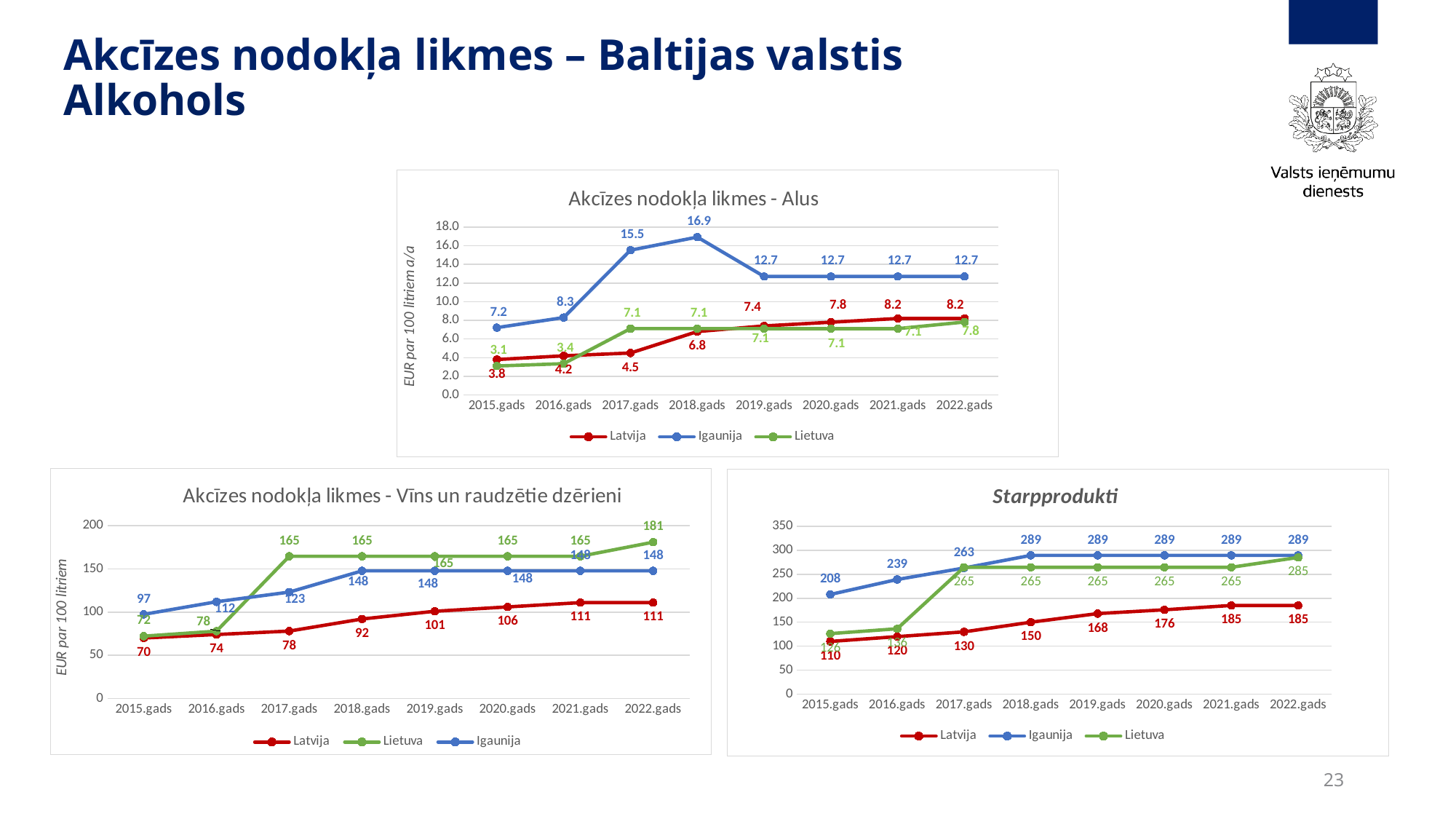
In the 'Akcīzes nodokļa likmes - Alus' chart, what is the value for Latvija in 2022.gads? 8.2 In the 'Akcīzes nodokļa likmes - Vīns un raudzētie dzērieni' chart, which is larger in 2017.gads: Lietuva or Igaunija? Lietuva In the 'Starpprodukti' chart, what is the difference between the Igaunija and Latvija values in 2022.gads? 104 In the 'Akcīzes nodokļa likmes - Alus' chart, what is the difference between the Igaunija and Latvija values in 2017.gads? 11.0 In the 'Akcīzes nodokļa likmes - Alus' chart, which year has the highest value for Igaunija? 2018.gads In the 'Akcīzes nodokļa likmes - Alus' chart, how many series does the legend list? 3 What type of chart is the 'Starpprodukti' chart? Line chart In the 'Akcīzes nodokļa likmes - Vīns un raudzētie dzērieni' chart, what is the value for Lietuva in 2022.gads? 181 In the 'Starpprodukti' chart, what is the value for Igaunija in 2016.gads? 239 In the 'Akcīzes nodokļa likmes - Vīns un raudzētie dzērieni' chart, which year has the lowest value for Latvija? 2015.gads In the 'Akcīzes nodokļa likmes - Alus' chart, what is the value for Igaunija in 2018.gads? 16.9 In the 'Akcīzes nodokļa likmes - Vīns un raudzētie dzērieni' chart, how many years are shown on the x axis? 8